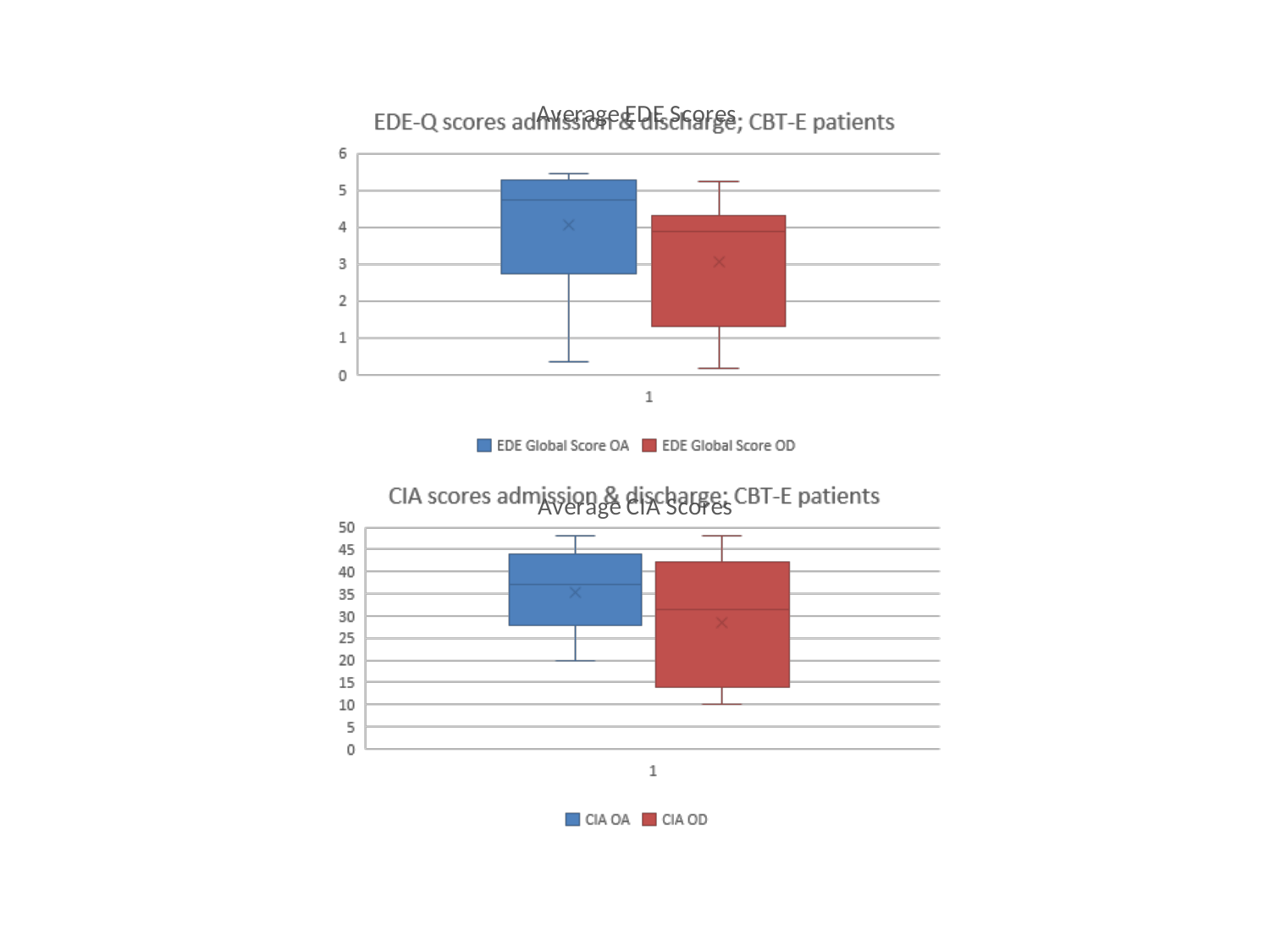
In the bottom chart, is the mean marker (x) for CIA OD greater or less than 30? less In the top chart, which series is shown in blue? EDE Global Score OA In the top chart, which series has the higher mean marker, EDE Global Score OA or EDE Global Score OD? EDE Global Score OA In the bottom chart, what are the two legend entries? CIA OA and CIA OD In the top chart, is the mean marker (x) for EDE Global Score OA greater or less than 3? greater In the top chart, is the bottom of the lower whisker for EDE Global Score OD greater or less than 1? less In the top chart, how many series does the legend list? 2 What kind of chart is the top chart on the slide? box-and-whisker (box plot) What kind of chart is the bottom chart on the slide? box-and-whisker (box plot) In the bottom chart, which series has the higher mean marker, CIA OA or CIA OD? CIA OA